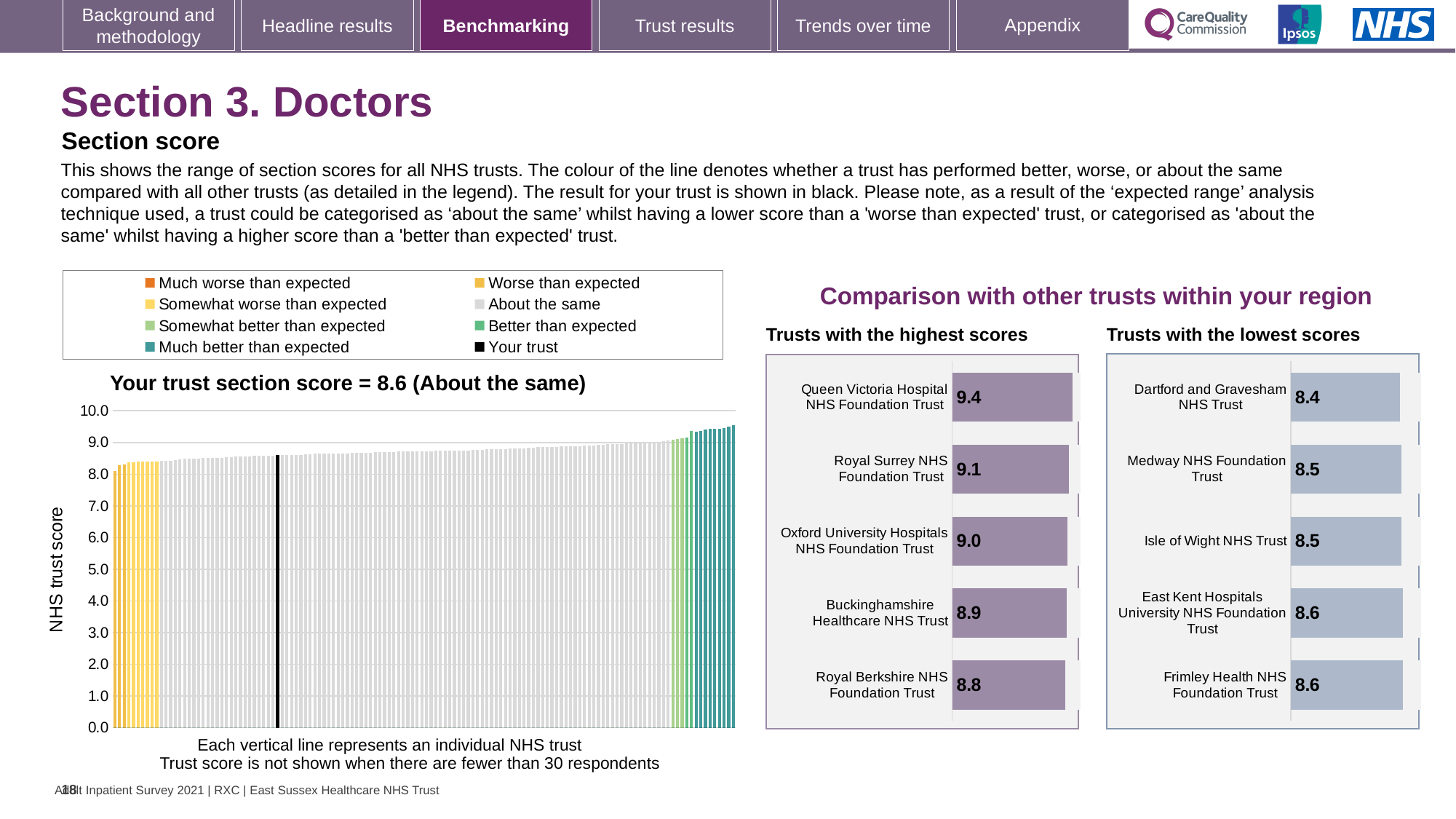
In the 'Trusts with the lowest scores' chart, which trust has the lowest score? Dartford and Gravesham NHS Trust In the 'Trusts with the lowest scores' chart, what is the score for Frimley Health NHS Foundation Trust? 8.6 In the 'Trusts with the highest scores' chart, which has the higher score: Royal Surrey NHS Foundation Trust or Oxford University Hospitals NHS Foundation Trust? Royal Surrey NHS Foundation Trust In the 'Trusts with the highest scores' chart, what is the score for Queen Victoria Hospital NHS Foundation Trust? 9.4 What kind of chart is the 'Trusts with the lowest scores' chart? Bar chart In the legend of the main chart on the left, what colour denotes 'Your trust'? Black In the 'Trusts with the lowest scores' chart, what is the score for Dartford and Gravesham NHS Trust? 8.4 In the 'Trusts with the highest scores' chart, what is the difference between the scores of Queen Victoria Hospital NHS Foundation Trust and Royal Berkshire NHS Foundation Trust? 0.6 In the main chart on the left, is the highest trust score greater or less than 9.0? greater According to the main chart on the left, what is your trust's section score? 8.6 In the 'Trusts with the highest scores' chart, which trust has the highest score? Queen Victoria Hospital NHS Foundation Trust How many trusts are shown in the 'Trusts with the highest scores' chart? 5